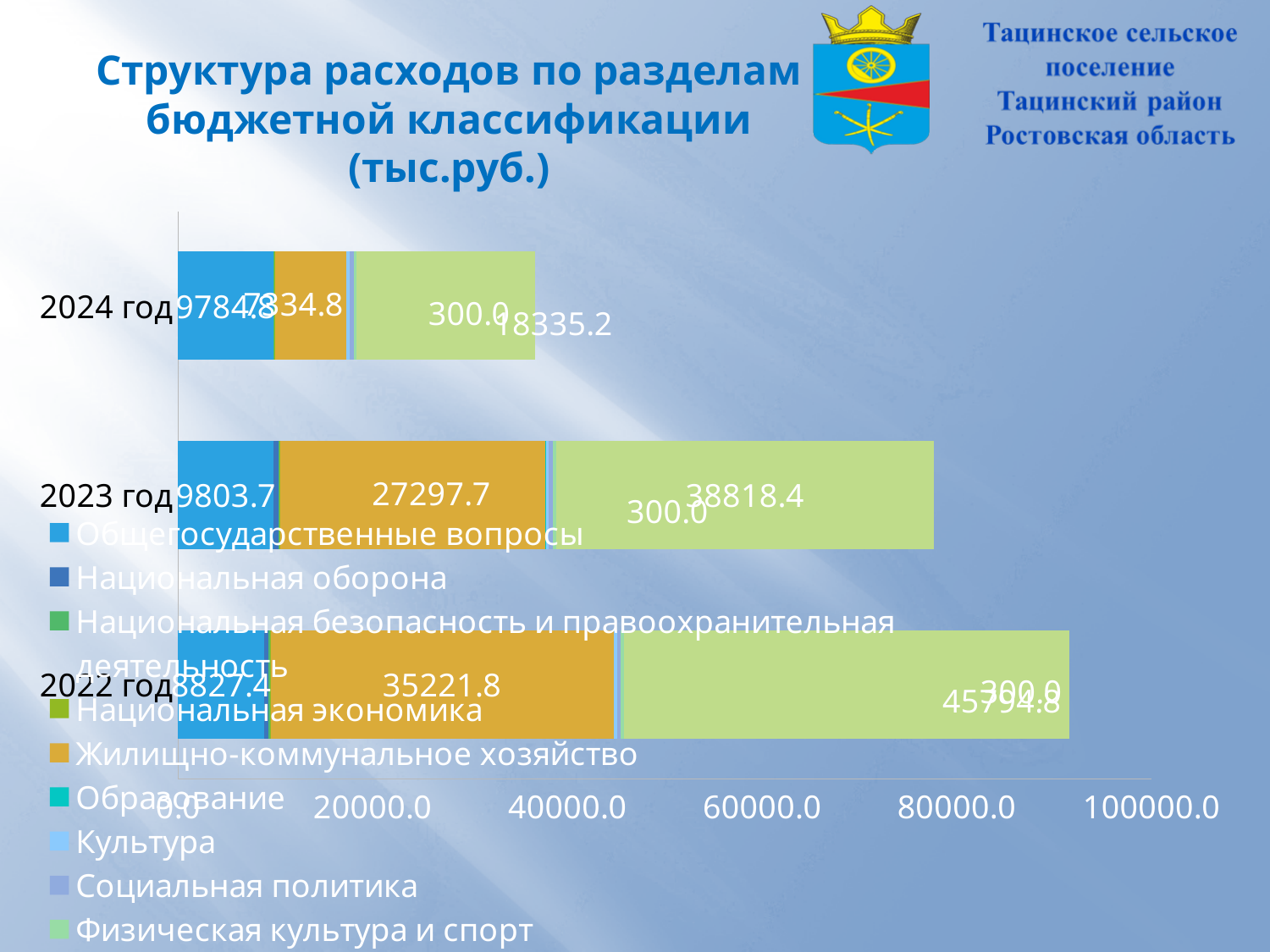
How many years (categories) are shown on the chart? 3 Does the value for Жилищно-коммунальное хозяйство rise or fall from 2022 год to 2024 год? fall How many series does the legend list? 9 What is the difference between the Жилищно-коммунальное хозяйство values for 2023 год and 2024 год? 19962.9 What is the value for Общегосударственные вопросы in 2022 год? 8827.4 What kind of chart is shown on the slide? bar chart Is the total length of the 2022 год bar greater or less than 80000.0? greater What is the value for Общегосударственные вопросы in 2023 год? 9803.7 What is the value for Жилищно-коммунальное хозяйство in 2024 год? 7334.8 In which year is the value for Общегосударственные вопросы the lowest? 2022 год What is the value for Жилищно-коммунальное хозяйство in 2022 год? 35221.8 In which year is the value for Жилищно-коммунальное хозяйство the highest? 2022 год